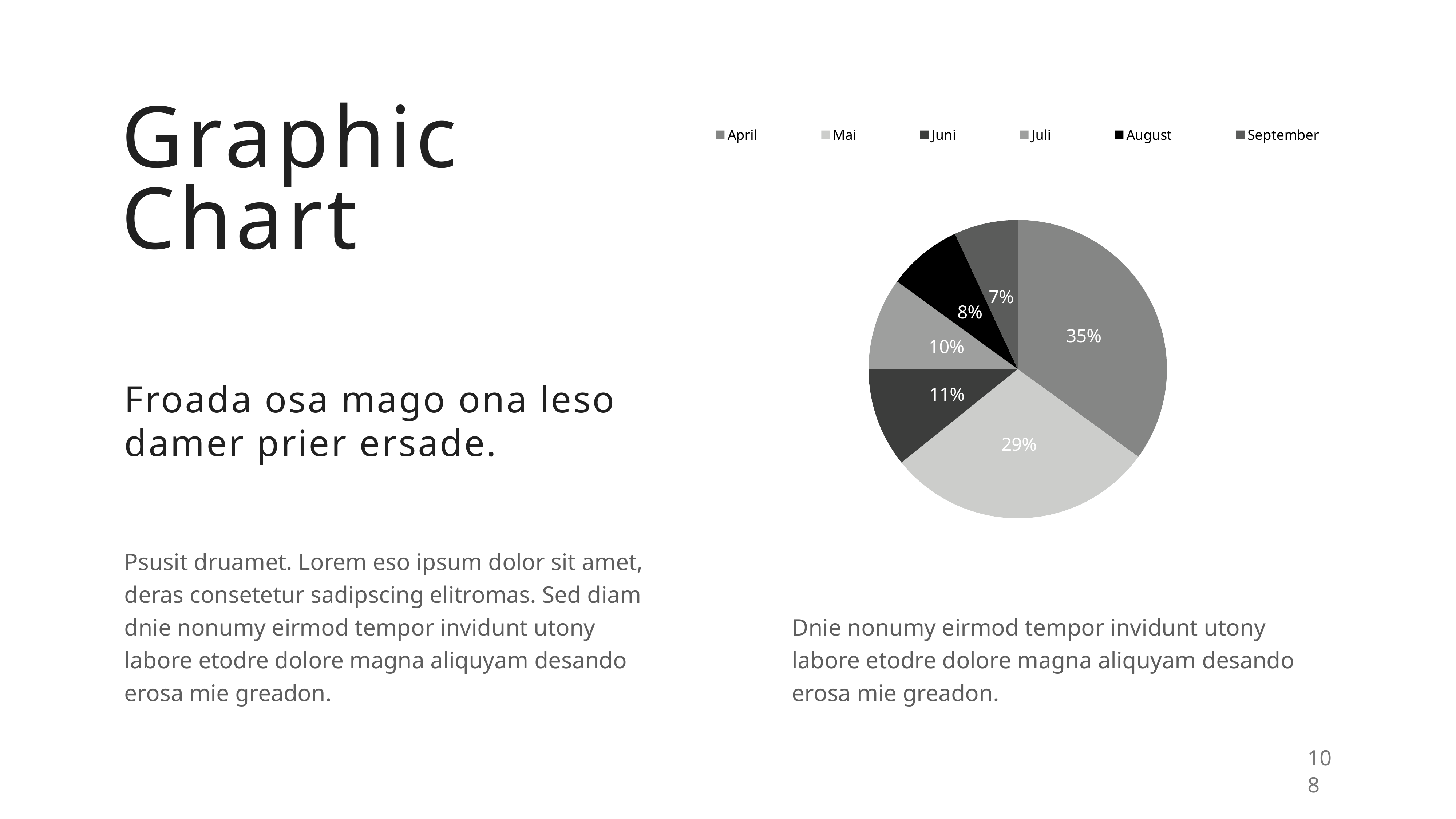
How many entries does the legend list? 6 What type of chart is shown on the slide? pie chart Which legend entry is shown in black? August What share of the pie does Juni have? 11% How many slices does the pie chart have? 6 Which is larger, the slice for Juli or the slice for September? Juli What share of the pie does August have? 8% Which month has the smallest slice of the pie? September What share of the pie does Mai have? 29% What is the difference in percentage points between April and Mai? 6 What share of the pie does April have? 35% Which month has the largest slice of the pie? April